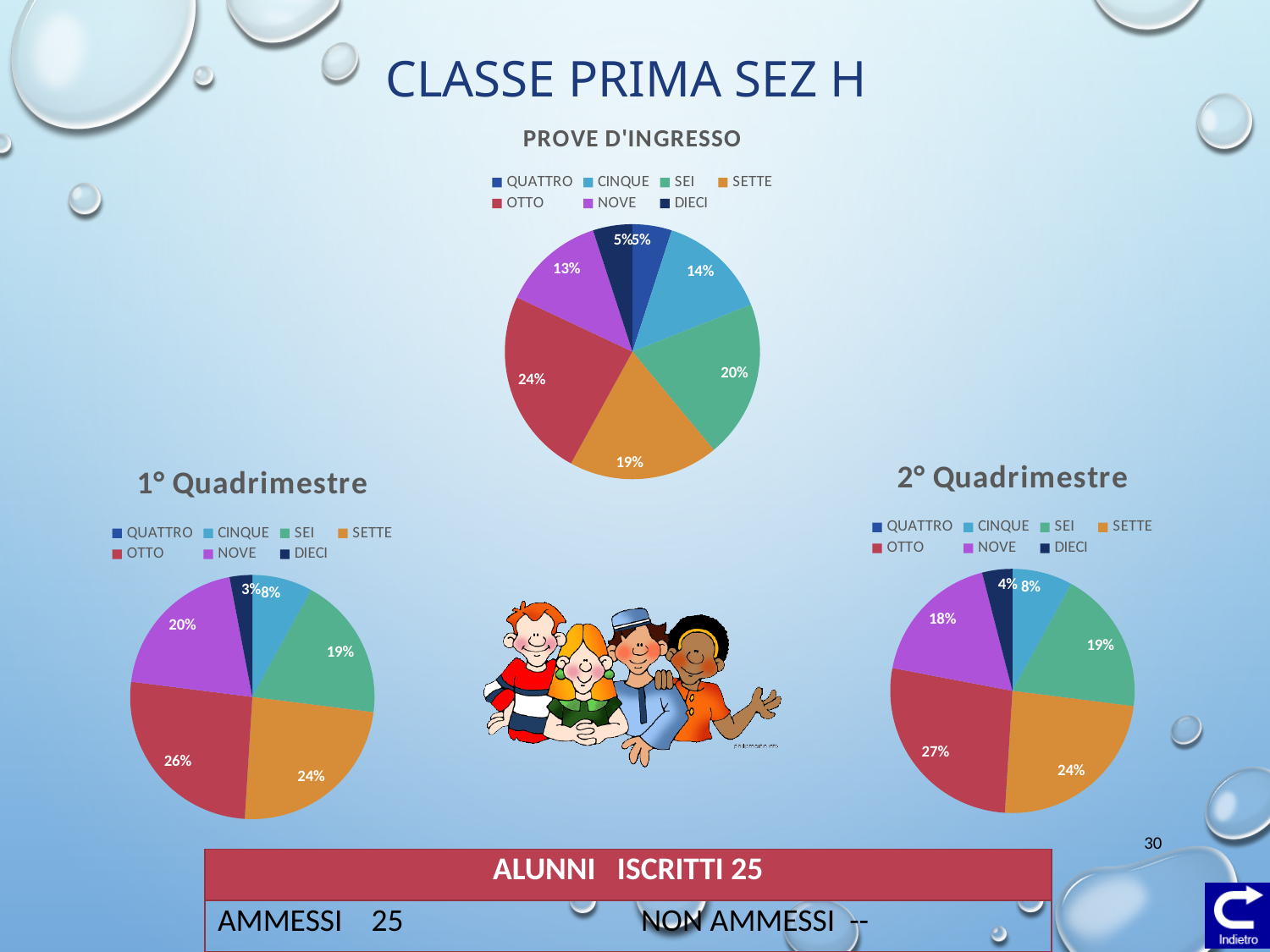
In the 1° Quadrimestre chart, what percentage is shown for OTTO? 26% What type of chart is the PROVE D'INGRESSO chart? pie chart In the 2° Quadrimestre chart, what percentage is shown for OTTO? 27% In the PROVE D'INGRESSO chart, what percentage is shown for OTTO? 24% In the 2° Quadrimestre chart, what percentage is shown for CINQUE? 8% In the 1° Quadrimestre chart, what is the difference between the SETTE and SEI percentages? 5% In the PROVE D'INGRESSO chart, what percentage is shown for SEI? 20% In the PROVE D'INGRESSO chart, what percentage is shown for CINQUE? 14% In the 1° Quadrimestre chart, what percentage is shown for NOVE? 20% In the 2° Quadrimestre chart, which is larger, SETTE or NOVE? SETTE How many entries does the legend of the PROVE D'INGRESSO chart list? 7 In the PROVE D'INGRESSO chart, which category has the largest slice? OTTO